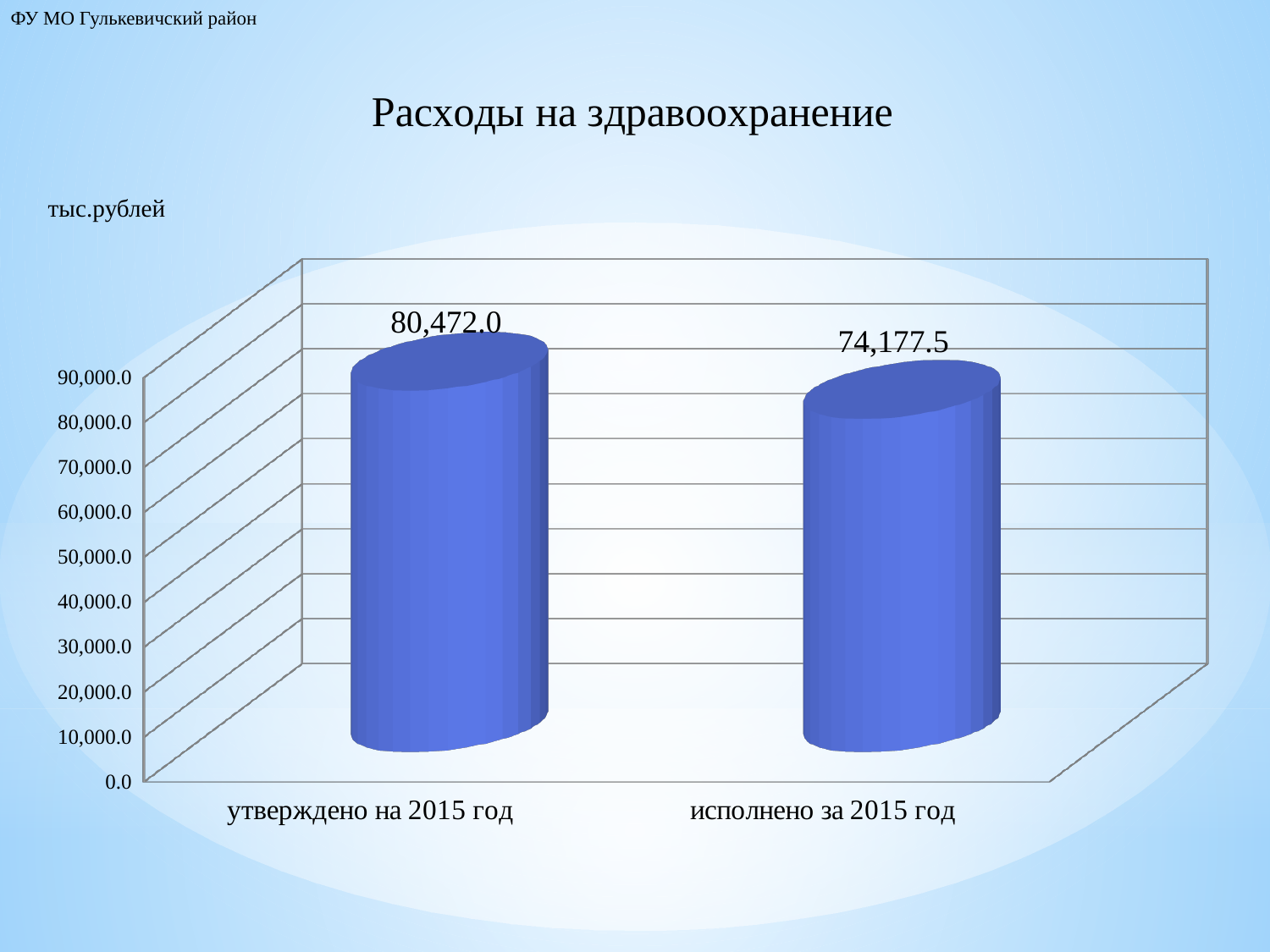
Which is larger: the value for утверждено на 2015 год or the value for исполнено за 2015 год? утверждено на 2015 год What kind of chart is shown on the slide? bar chart What is the value for исполнено за 2015 год? 74,177.5 What is the value for утверждено на 2015 год? 80,472.0 In what units are the values on the chart expressed? тыс.рублей What is the title of the chart? Расходы на здравоохранение Which category has the lowest value? исполнено за 2015 год Which category has the highest value? утверждено на 2015 год What is the difference between the value for утверждено на 2015 год and the value for исполнено за 2015 год? 6,294.5 How many categories are shown on the chart? 2 Is the value for исполнено за 2015 год greater or less than 60,000.0? greater Is the value for утверждено на 2015 год greater or less than 90,000.0? less